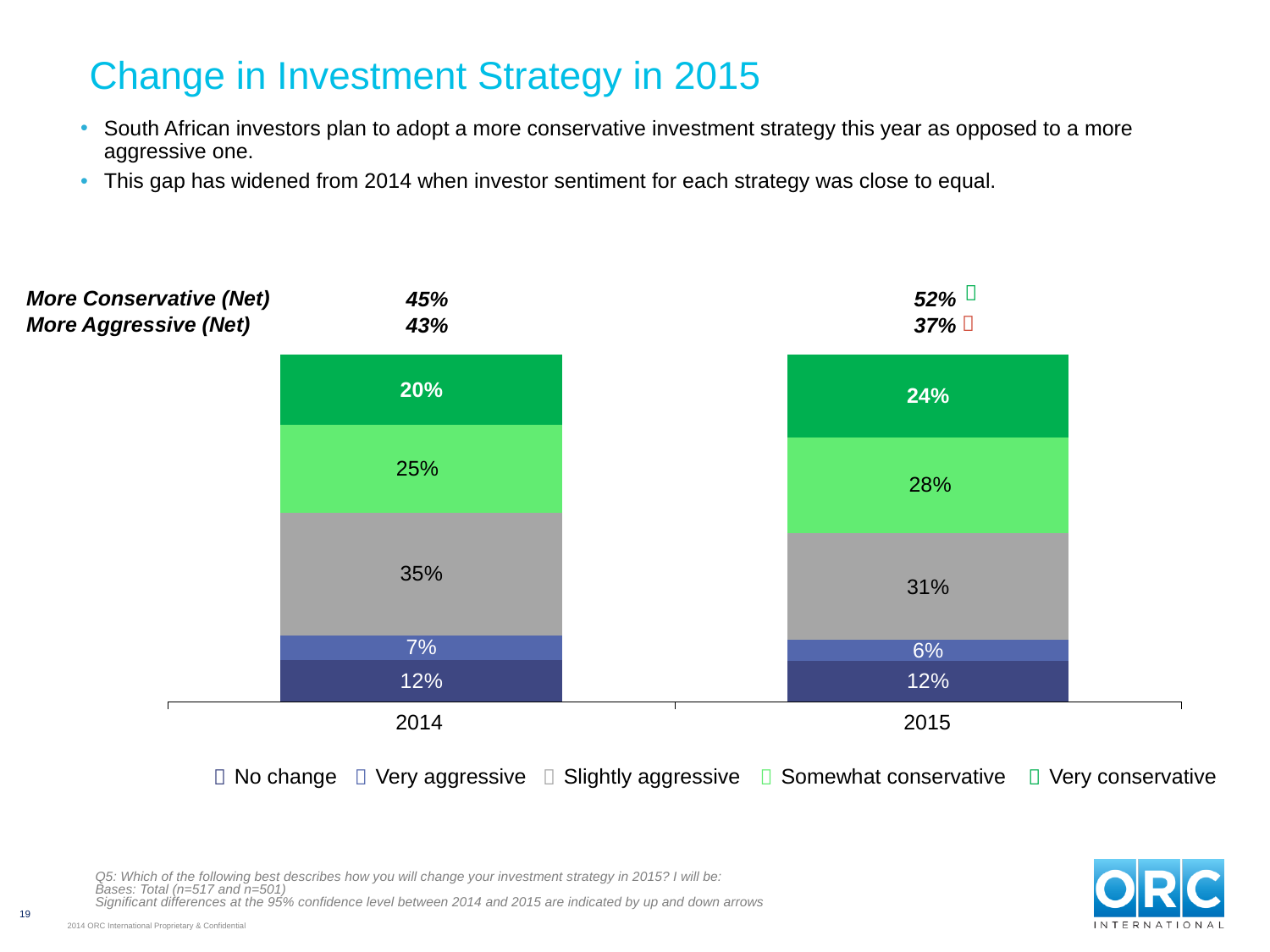
What is the value for No change in 2014? 12% Which segment is the smallest in the 2014 bar? Very aggressive What is the More Conservative (Net) value shown for 2015? 52% What is the value for Slightly aggressive in 2014? 35% How many series does the legend list? 5 What is the value for Very conservative in 2015? 24% What is the difference between the Somewhat conservative values for 2015 and 2014? 3% How many categories are shown on the x axis? 2 What kind of chart is shown on the slide? Stacked bar chart What is the value for Very aggressive in 2015? 6% Is the Very conservative value larger in 2014 or 2015? 2015 Which segment is the largest in the 2015 bar? Slightly aggressive